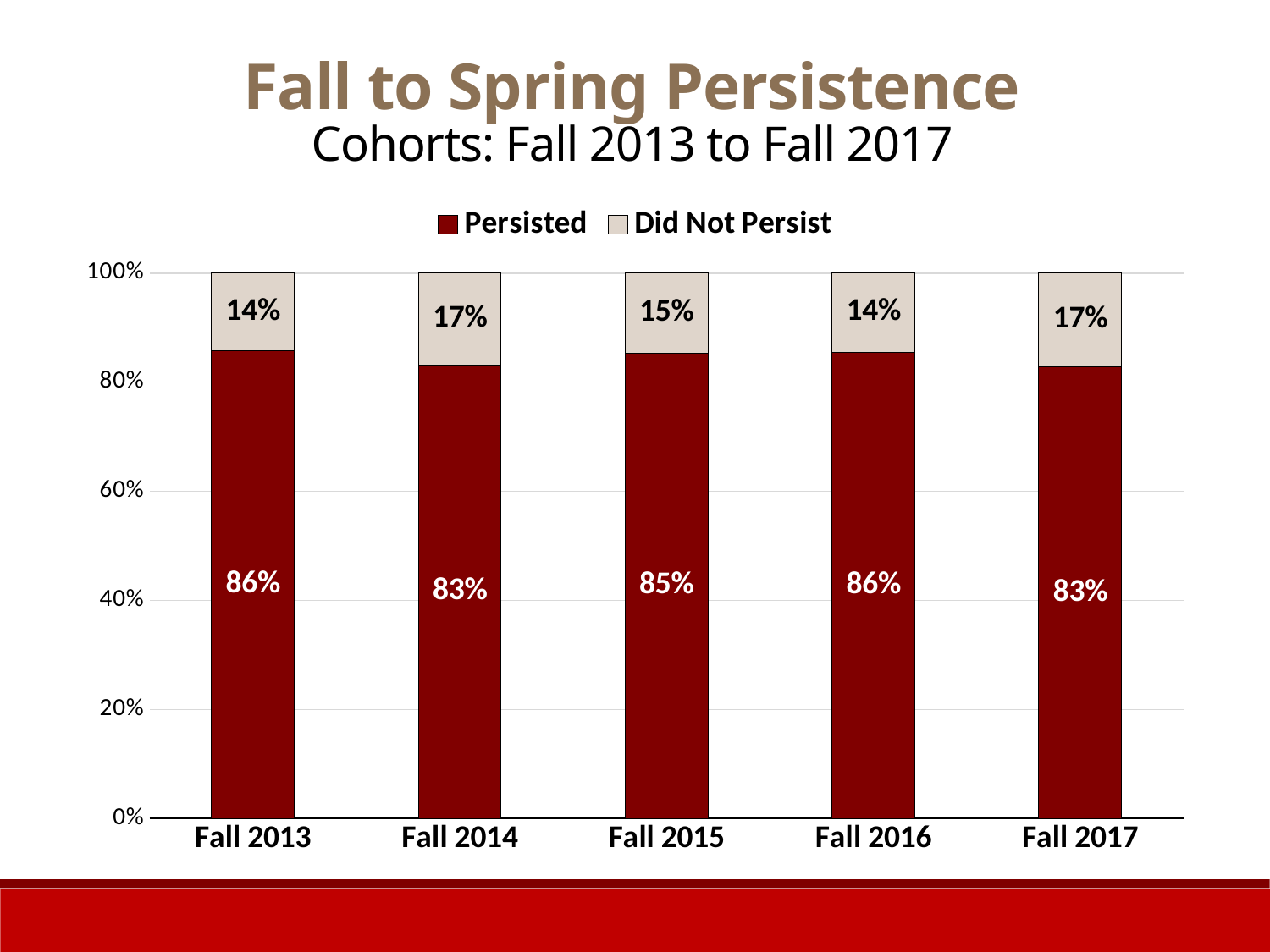
How many series does the legend list? 2 What is the Did Not Persist value for Fall 2016? 14% What percentage of the Fall 2013 cohort persisted? 86% What is the total of the stacked bar for Fall 2015? 100% What is the difference between the Persisted values for Fall 2013 and Fall 2014? 3% What are the two series named in the legend? Persisted and Did Not Persist Which cohort has the lowest Persisted value, Fall 2013 or Fall 2014? Fall 2014 What kind of chart is shown on the slide? Stacked bar chart What is the Persisted value for Fall 2017? 83% How many cohorts are shown on the x axis? 5 What percentage of the Fall 2014 cohort did not persist? 17% What is the Persisted value for Fall 2015? 85%